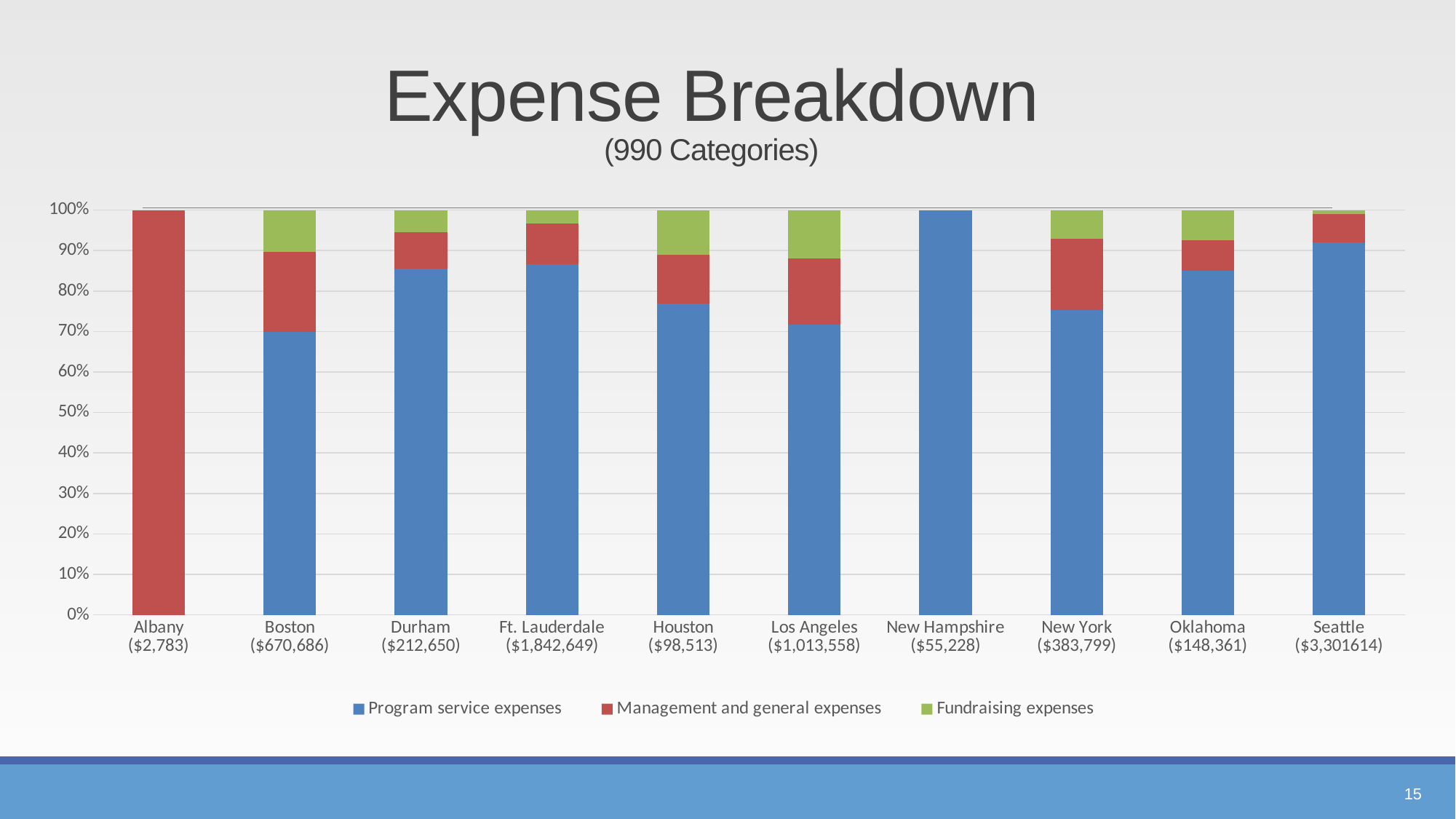
What total expense amount is shown under the Seattle label? $3,301614 How many series does the legend list? 3 Is the Program service expenses share for Boston greater or less than 80%? less What share of Albany's expenses is Management and general expenses? 100% Which location has the highest share of Program service expenses? New Hampshire What kind of chart is shown on the slide? Stacked bar chart How many categories (locations) are shown on the x axis? 10 Which location has the lowest share of Program service expenses? Albany Which has a larger share of Program service expenses, Boston or Durham? Durham What share of New Hampshire's expenses is Program service expenses? 100% Is the Program service expenses share for Los Angeles greater or less than 80%? less Is the Program service expenses share for Seattle greater or less than 90%? greater